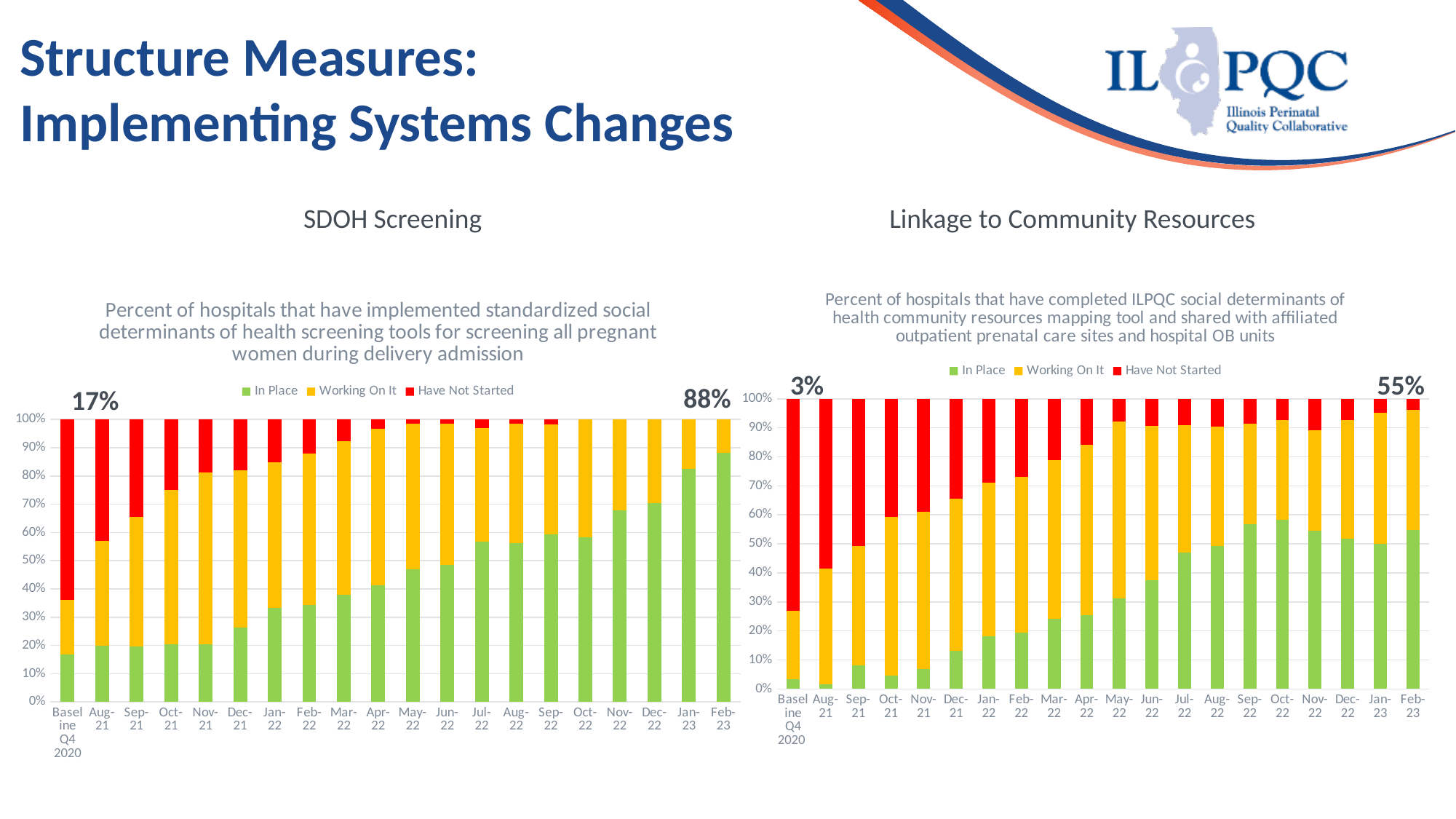
In the Linkage to Community Resources chart, does the In Place (green) portion generally rise or fall from Baseline Q4 2020 to Feb-23? Rise In the Linkage to Community Resources chart, what is the In Place value labeled for Feb-23? 55% Which chart shows the larger labeled In Place value for Feb-23, SDOH Screening or Linkage to Community Resources? SDOH Screening What kind of chart is the SDOH Screening chart? Stacked bar chart How many time-period categories are shown on the x axis of the Linkage to Community Resources chart? 20 In the SDOH Screening chart, by how many percentage points did the labeled In Place value increase from Baseline Q4 2020 to Feb-23? 71 percentage points How many series does the legend of the SDOH Screening chart list? 3 In the Linkage to Community Resources chart, by how many percentage points did the labeled In Place value increase from Baseline Q4 2020 to Feb-23? 52 percentage points In the SDOH Screening chart, what is the In Place value labeled for Feb-23? 88% In the Linkage to Community Resources chart, what is the In Place value labeled for the Baseline Q4 2020 bar? 3% In the SDOH Screening chart, what is the In Place value labeled for the Baseline Q4 2020 bar? 17% In the SDOH Screening chart, is the In Place value for Nov-22 greater or less than 60%? greater